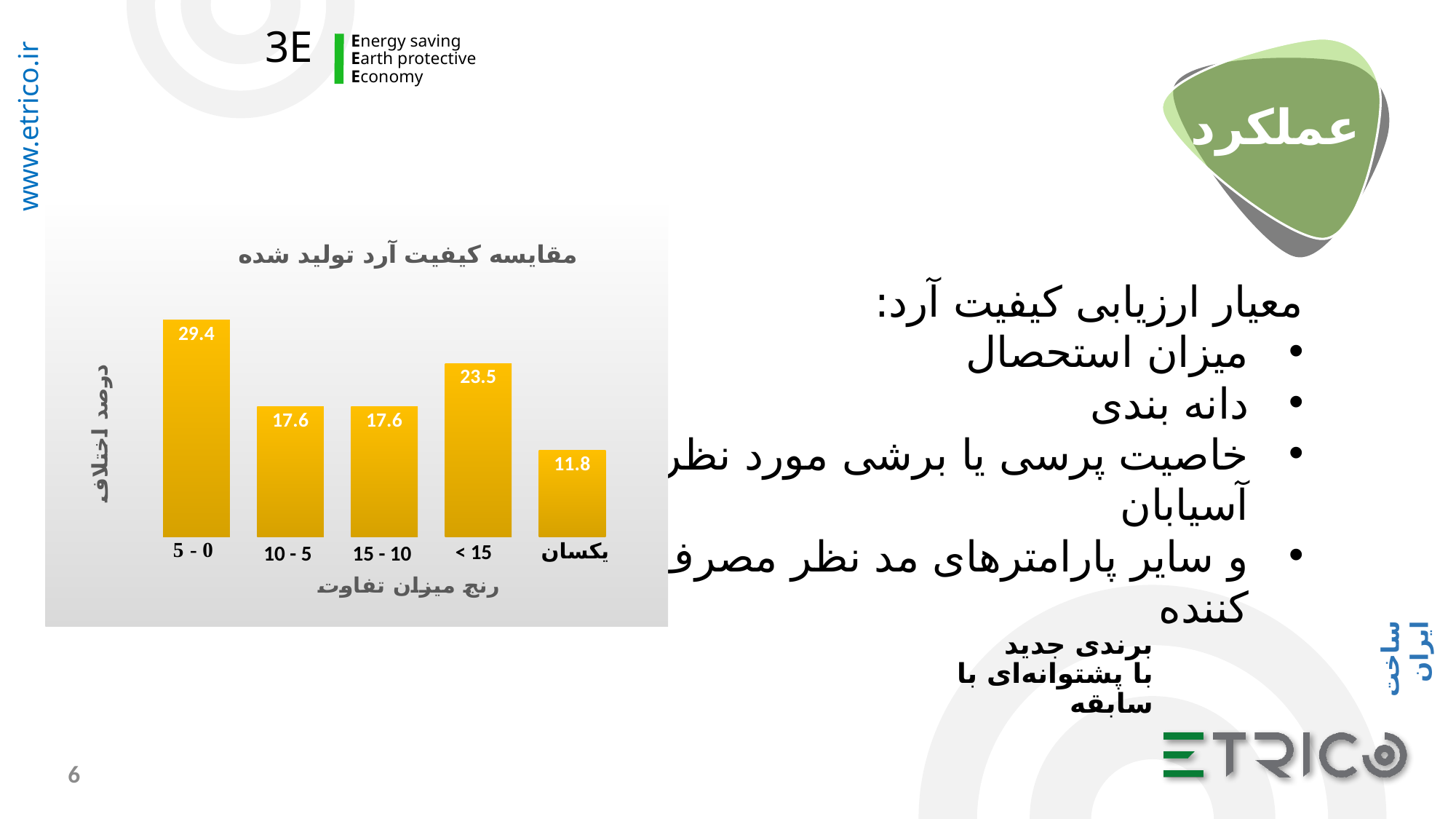
Which category has the highest value? 5 - 0 Which is larger, the value for "< 15" or the value for "10 - 5"? < 15 Which category has the lowest value? یکسان What is the value for the "< 15" category? 23.5 What is the value for the "5 - 0" category? 29.4 What is the difference between the values for "< 15" and "15 - 10"? 5.9 How many categories are shown on the x axis? 5 What is the title of the chart? مقایسه کیفیت آرد تولید شده What is the value for the "10 - 5" category? 17.6 What type of chart is shown on the slide? bar chart What is the difference between the values for "5 - 0" and "یکسان"? 17.6 What is the value for the "یکسان" category? 11.8